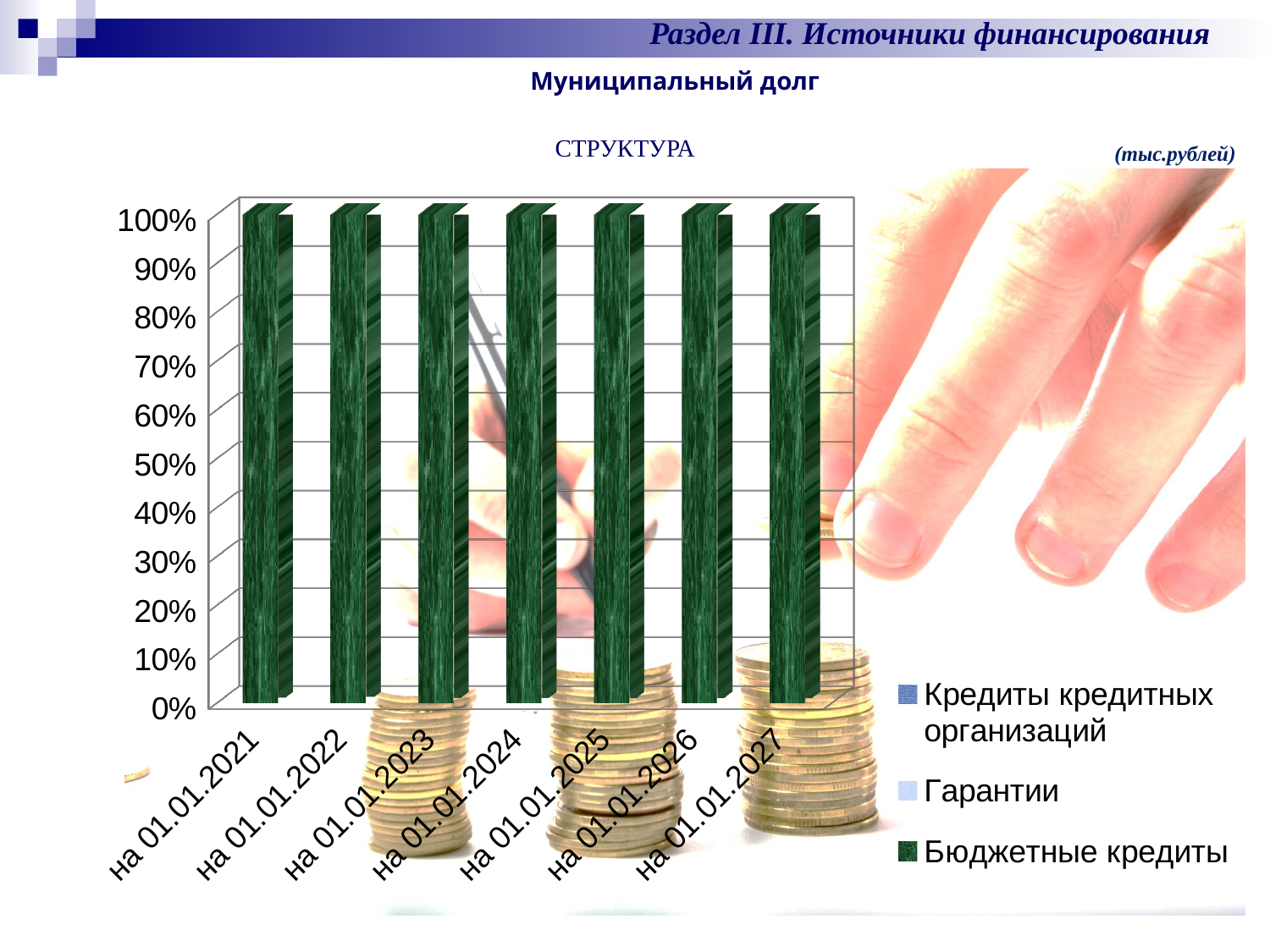
How many categories (dates) are shown on the x axis of the chart? 7 What is the highest value shown on the y axis? 100% Does the share of Бюджетные кредиты rise, fall, or stay the same from на 01.01.2021 to на 01.01.2027? stays the same What is the last category on the x axis? на 01.01.2027 Is the value for Бюджетные кредиты at на 01.01.2024 greater or less than 50%? greater What share of the bar for на 01.01.2021 is made up by Бюджетные кредиты? 100% Which series does the dark green colour represent in the legend? Бюджетные кредиты What share of the bar for на 01.01.2027 is made up by Бюджетные кредиты? 100% What is the title of the chart? СТРУКТУРА How many series does the chart legend list? 3 What kind of chart is shown on the slide? bar chart What is the first category on the x axis? на 01.01.2021